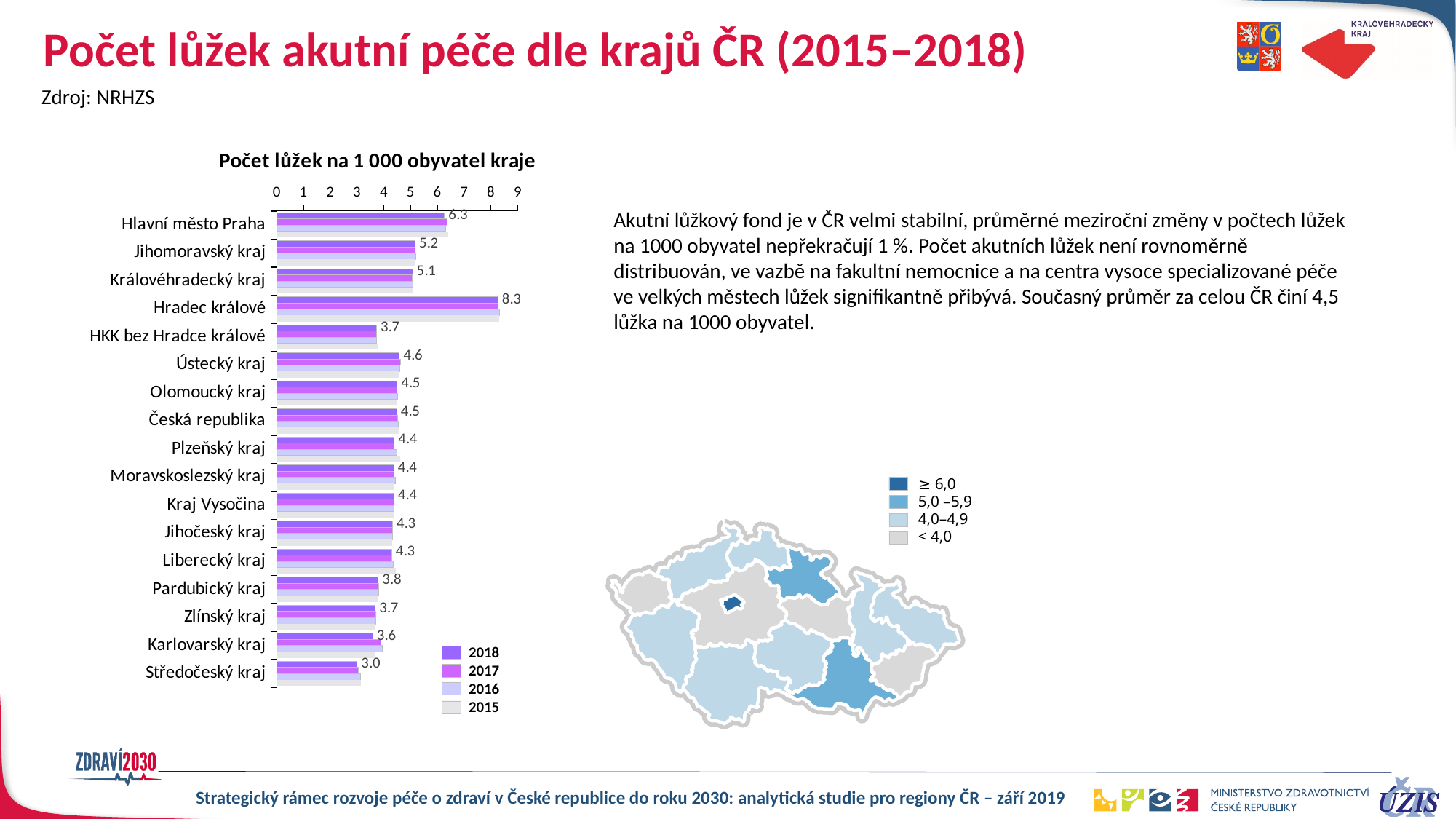
What type of chart is shown on the slide? bar chart What is the labelled value for Středočeský kraj in the chart? 3.0 Which has a larger labelled value, Jihomoravský kraj or Královéhradecký kraj? Jihomoravský kraj What is the labelled value for Hlavní město Praha in the chart? 6.3 What is the labelled value for Hradec králové in the chart? 8.3 How many series does the chart legend list? 4 How many categories are listed on the vertical axis of the chart? 17 What is the difference between the labelled values for Hradec králové and Hlavní město Praha? 2.0 Which category has the highest labelled value in the chart? Hradec králové What is the title of the bar chart? Počet lůžek na 1 000 obyvatel kraje Which category has the lowest labelled value in the chart? Středočeský kraj What is the labelled value for Česká republika in the chart? 4.5